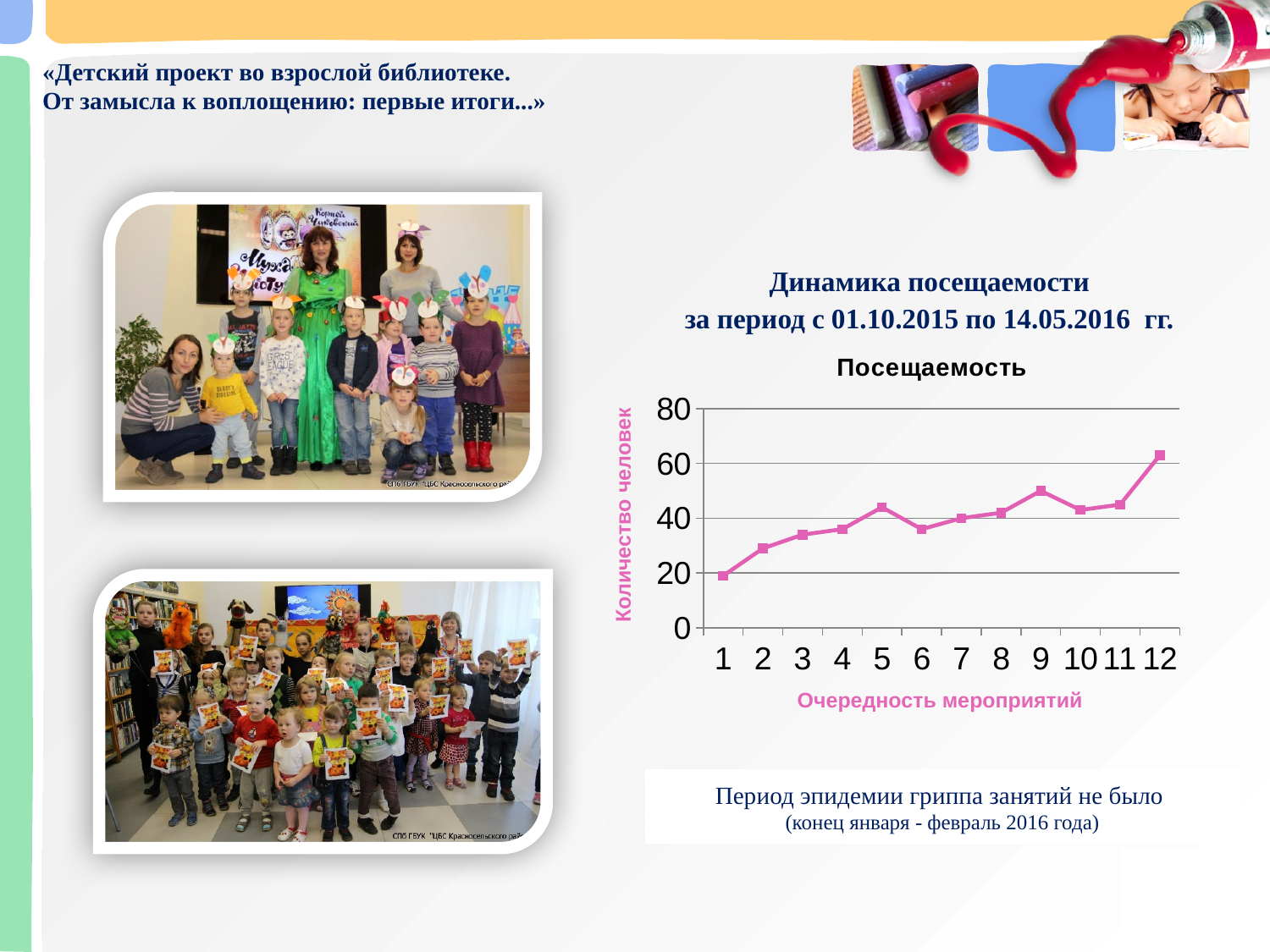
What is the title of the chart? Посещаемость How many data points are plotted on the line chart? 12 Is the attendance value for event 12 greater or less than 40? greater Is the attendance value for event 2 greater or less than 40? less What kind of chart is shown on the slide? line chart Is the attendance value for event 1 greater or less than 40? less Which event number (Очередность мероприятий) has the highest attendance? 12 Which event number has the lowest attendance? 1 What is the label of the vertical axis of the chart? Количество человек Which has higher attendance: event 9 or event 6? event 9 Overall, does attendance rise or fall from event 1 to event 12? rise